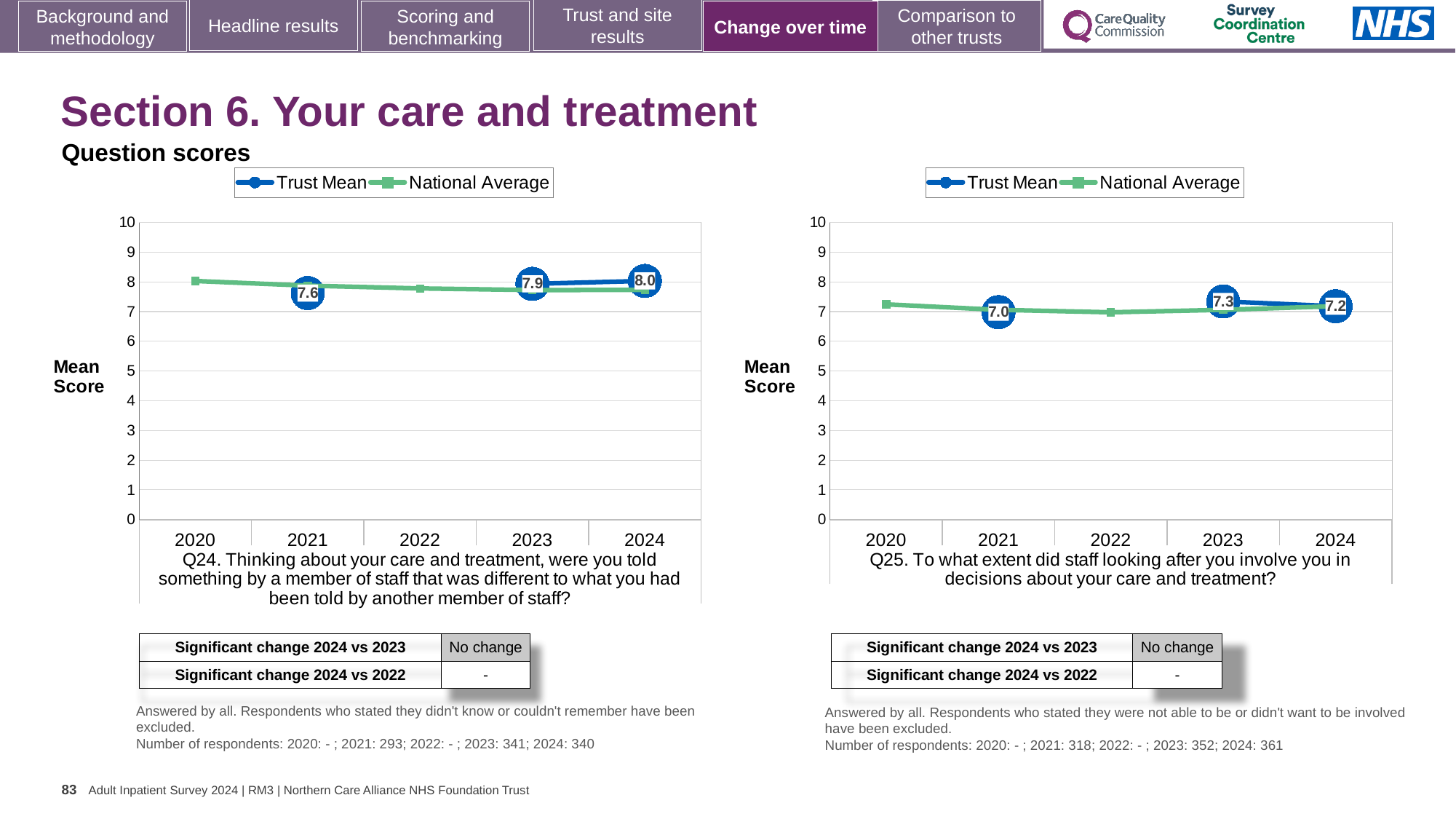
In the Q24 chart on the left, what is the Trust Mean score for 2021? 7.6 How many series does the legend of the Q25 chart on the right list? 2 In the Q25 chart on the right, which year has the lowest labelled Trust Mean score? 2021 What kind of chart is the Q24 chart on the left? Line chart In the Q25 chart on the right, what is the Trust Mean score for 2023? 7.3 In the Q24 chart on the left, which year has the highest labelled Trust Mean score? 2024 In the Q24 chart on the left, does the Trust Mean score rise or fall from 2021 to 2024? Rise In the Q25 chart on the right, is the Trust Mean score for 2023 larger or smaller than for 2024? larger In the Q24 chart on the left, what is the Trust Mean score for 2024? 8.0 In the Q24 chart on the left, by how much did the Trust Mean score increase from 2021 to 2024? 0.4 In the Q25 chart on the right, what is the Trust Mean score for 2024? 7.2 In the Q24 chart on the left, is the National Average value for 2022 greater or less than 7? greater